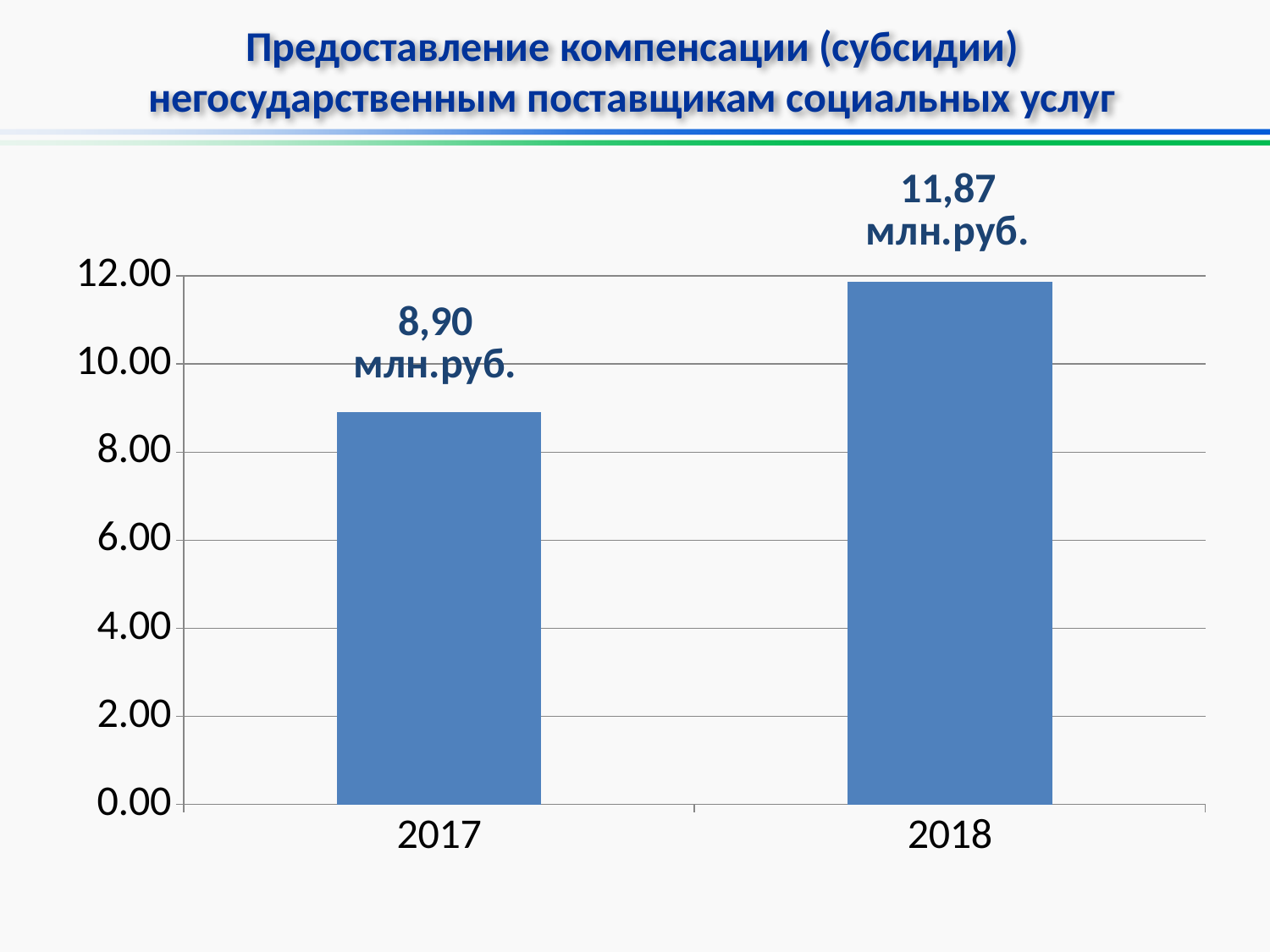
Which year has the lowest value? 2017 Is the value for 2018 greater or less than 10.00? greater Which year has the highest value? 2018 How many categories are shown on the x axis? 2 Which is larger, the value for 2017 or the value for 2018? 2018 Do the values rise or fall from 2017 to 2018? rise What is the value for 2017? 8,90 млн.руб. What kind of chart is shown on the slide? bar chart What is the title of the slide? Предоставление компенсации (субсидии) негосударственным поставщикам социальных услуг What is the value for 2018? 11,87 млн.руб. Is the value for 2017 greater or less than 10.00? less What is the difference between the values for 2018 and 2017? 2,97 млн.руб.